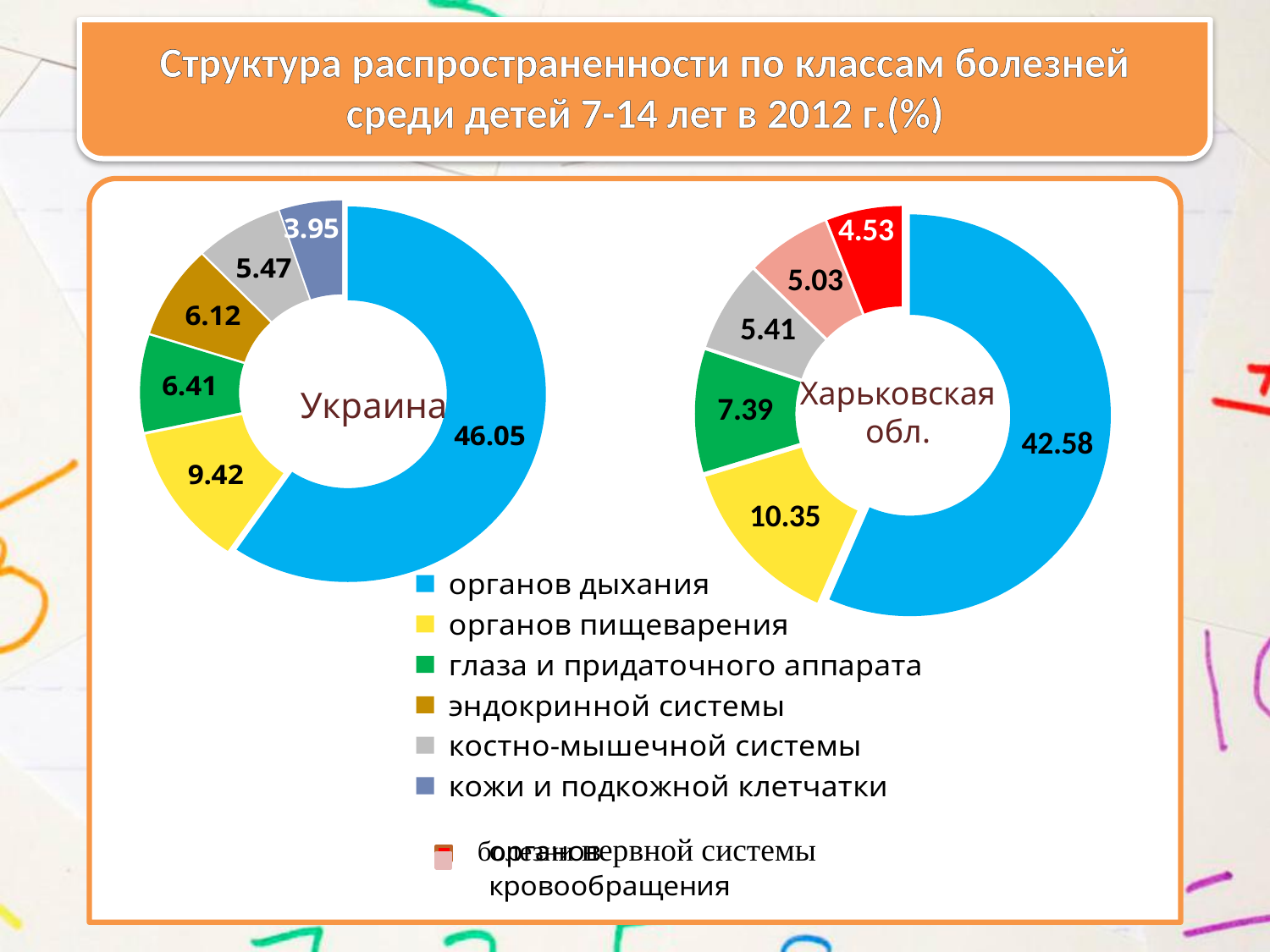
In the Украина chart, what is the value for эндокринной системы? 6.12 What is the difference between the органов дыхания value in the Украина chart and in the Харьковская обл. chart? 3.47 Which chart shows a larger value for органов пищеварения, Украина or Харьковская обл.? Харьковская обл. In the Украина chart, what is the difference between глаза и придаточного аппарата and эндокринной системы? 0.29 In the Украина chart, which category has the smallest share? кожи и подкожной клетчатки In the Украина chart, what is the value for органов дыхания? 46.05 In the Харьковская обл. chart, what is the value for глаза и придаточного аппарата? 7.39 What colour represents органов дыхания in the charts? Blue How many slices does the Украина chart have? 6 In the Харьковская обл. chart, what is the value for органов пищеварения? 10.35 What kind of chart is used on this slide? Doughnut (pie) chart In the Украина chart, which category has the largest share? органов дыхания